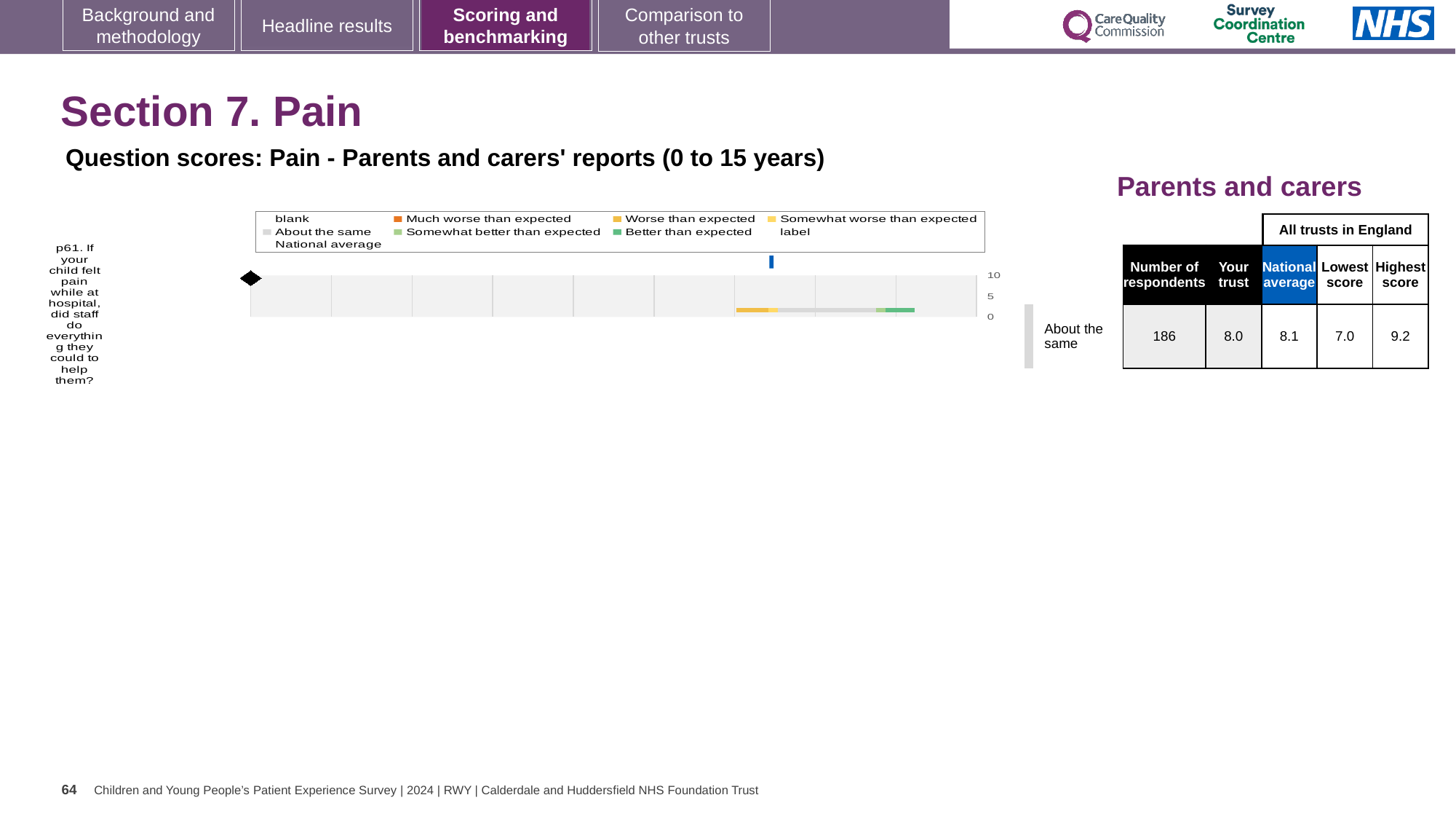
How many respondents answered question p61? 186 How many survey questions are plotted in the chart? 1 Which benchmarking category is the trust's result for question p61 placed in? About the same What colour does the legend use for 'Much worse than expected'? Orange What is the highest score among all trusts in England for question p61? 9.2 What is the difference between the highest and lowest scores for question p61? 2.2 According to the table beside the chart, what is the national average score for question p61? 8.1 Which is larger for question p61: the 'Your trust' score or the national average? National average What kind of chart is shown on the slide for question p61? bar chart What is the lowest score among all trusts in England for question p61? 7.0 By how much does the national average exceed the 'Your trust' score for question p61? 0.1 According to the table beside the chart, what is the 'Your trust' score for question p61? 8.0